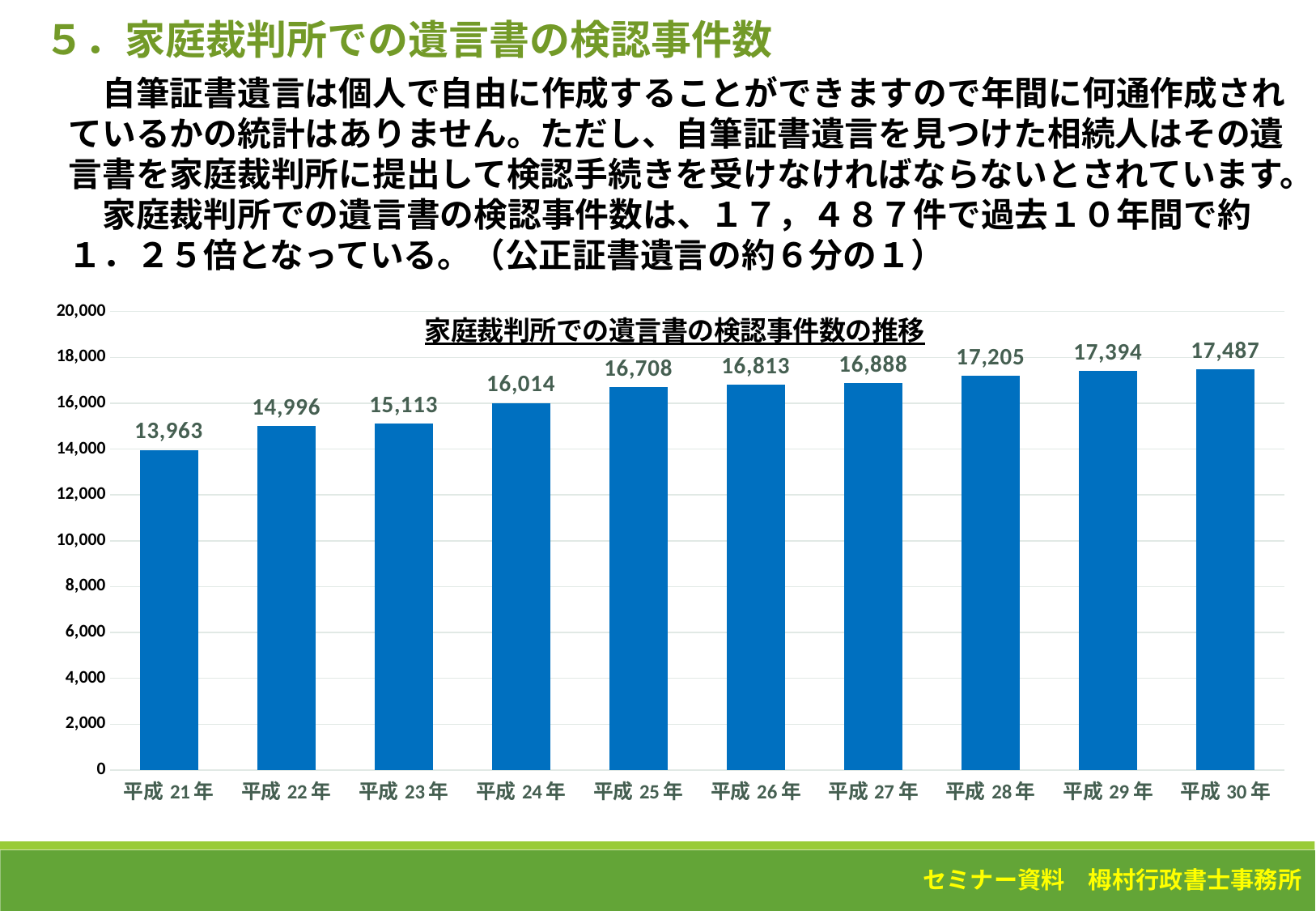
Which year has the highest value? 平成30年 What is the difference between the values for 平成30年 and 平成21年? 3,524 What is the value for 平成21年? 13,963 What is the value for 平成28年? 17,205 Is the value for 平成27年 greater or less than 16,000? greater What kind of chart is shown? bar chart What is the value for 平成25年? 16,708 Which is larger, the value for 平成22年 or the value for 平成24年? 平成24年 What is the difference between the values for 平成24年 and 平成23年? 901 Which year has the lowest value? 平成21年 How many years are shown on the x axis? 10 Do the values rise or fall from 平成21年 to 平成30年? rise